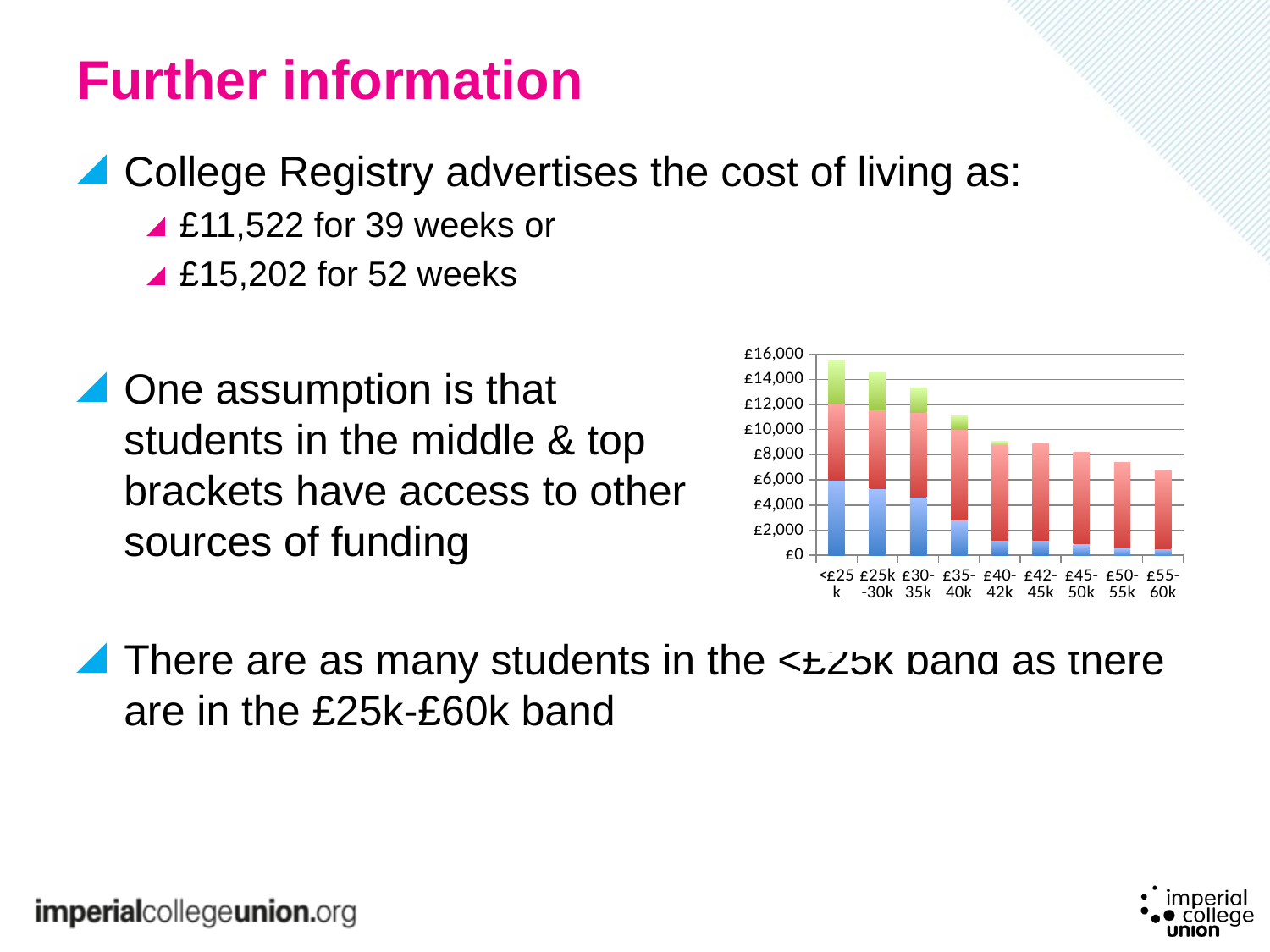
Which colour segment appears at the top of the stacked bars for the lower income bands but is absent from the £42-45k band onwards? green How many income bands are shown on the x axis of the chart? 9 Do the total bar heights rise or fall as you move from the <£25k band to the £55-60k band? fall Is the total bar height for the £40-42k band greater or less than £10,000? less Is the total bar height for the <£25k band greater or less than £14,000? greater Which income band has the shortest stacked bar in the chart? £55-60k What kind of chart is shown on the slide? stacked bar chart What is the highest value labelled on the chart's y axis? £16,000 Which has the taller stacked bar, the £25k-30k band or the £30-35k band? £25k-30k Is the total bar height for the £35-40k band greater or less than £10,000? greater Which income band has the tallest stacked bar in the chart? <£25k